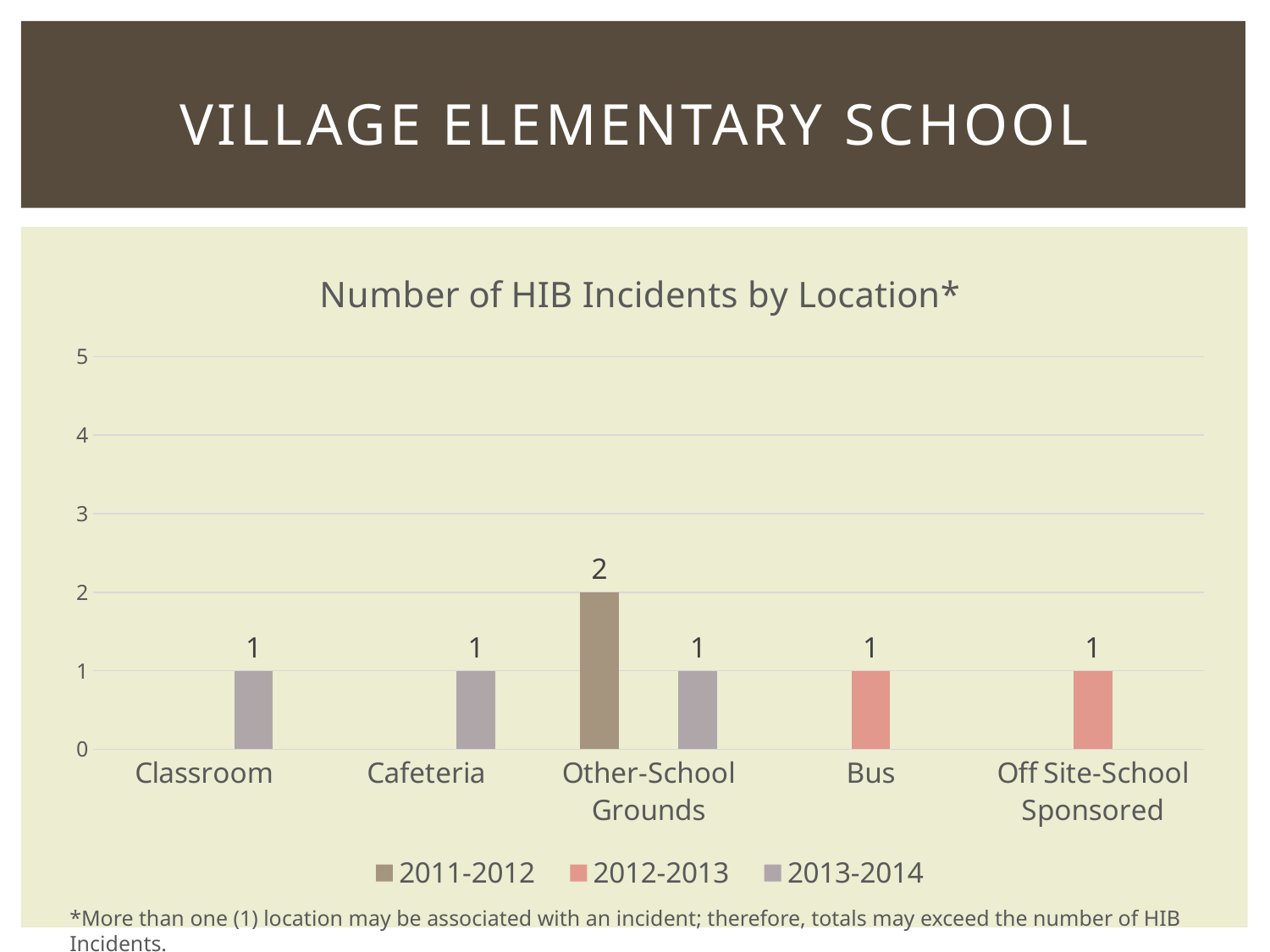
What kind of chart is shown on the slide? Bar chart How many location categories are shown on the x axis? 5 What is the difference between the 2011-2012 and 2013-2014 values for Other-School Grounds? 1 What is the number of HIB incidents for Bus in 2012-2013? 1 Which location has the highest single bar in the chart? Other-School Grounds What is the title of the chart? Number of HIB Incidents by Location* What is the number of HIB incidents for Cafeteria in 2013-2014? 1 What is the number of HIB incidents for Off Site-School Sponsored in 2012-2013? 1 What is the number of HIB incidents for Classroom in 2013-2014? 1 Which is larger: the 2011-2012 value for Other-School Grounds or the 2012-2013 value for Bus? 2011-2012 value for Other-School Grounds How many series does the legend list? 3 What is the number of HIB incidents for Other-School Grounds in 2011-2012? 2